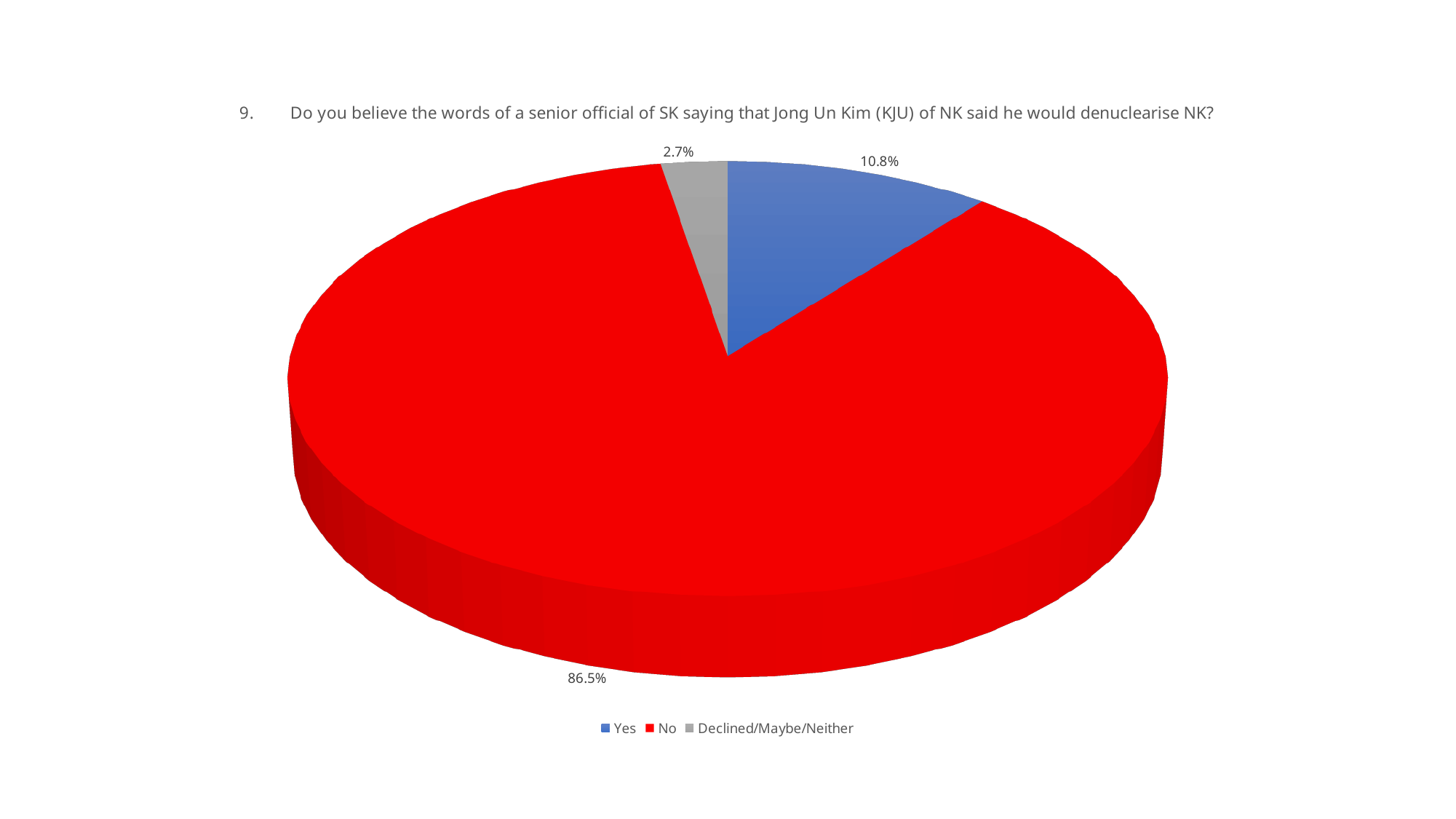
How many categories does the legend list? 3 What percentage of respondents answered "Yes"? 10.8% Which response has the largest share of the pie? No Which is larger, the share for "Yes" or the share for "Declined/Maybe/Neither"? Yes What percentage of respondents answered "No"? 86.5% What percentage of respondents answered "Declined/Maybe/Neither"? 2.7% What kind of chart is shown on the slide? Pie chart What colour is the "No" slice? Red What colour is the "Yes" slice? Blue Which response has the smallest share of the pie? Declined/Maybe/Neither What is the difference in percentage points between the "Yes" and "Declined/Maybe/Neither" shares? 8.1 What is the difference in percentage points between the "No" and "Yes" shares? 75.7